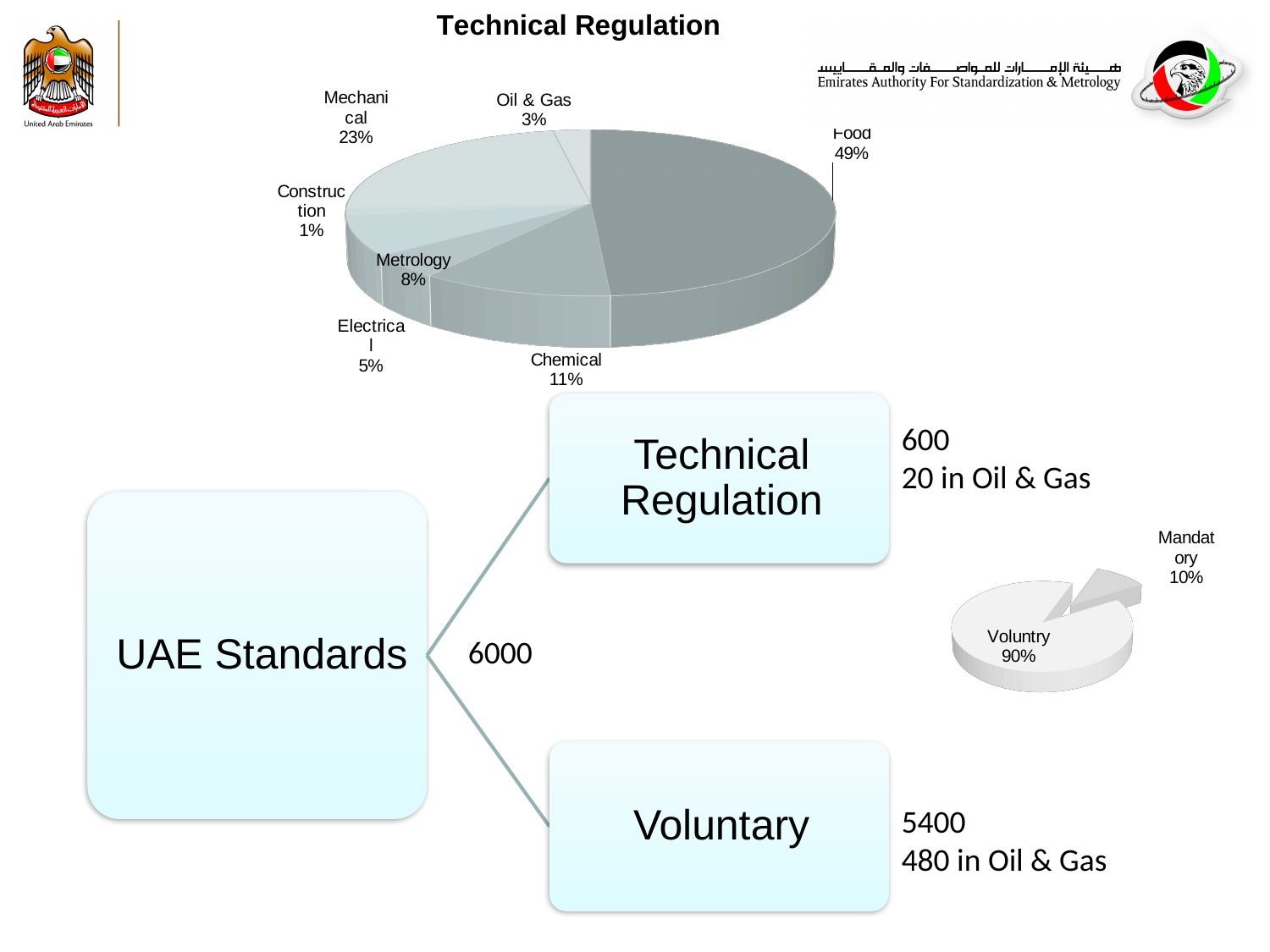
In the Technical Regulation pie chart, what is the difference between the Food share and the Mechanical share? 26% In the small pie chart at the bottom right of the slide, what share is Mandatory? 10% In the Technical Regulation pie chart, which category has the largest share? Food In the Technical Regulation pie chart, which category has the smallest share? Construction How many categories are shown in the Technical Regulation pie chart? 7 In the small pie chart at the bottom right of the slide, what share is Voluntary? 90% In the Technical Regulation pie chart, what share does Oil & Gas have? 3% In the Technical Regulation pie chart, what share does Chemical have? 11% What kind of chart is the Technical Regulation chart at the top of the slide? Pie chart In the Technical Regulation pie chart, which is larger, Metrology or Electrical? Metrology In the Technical Regulation pie chart, what share does Mechanical have? 23% In the Technical Regulation pie chart, what share does Food have? 49%